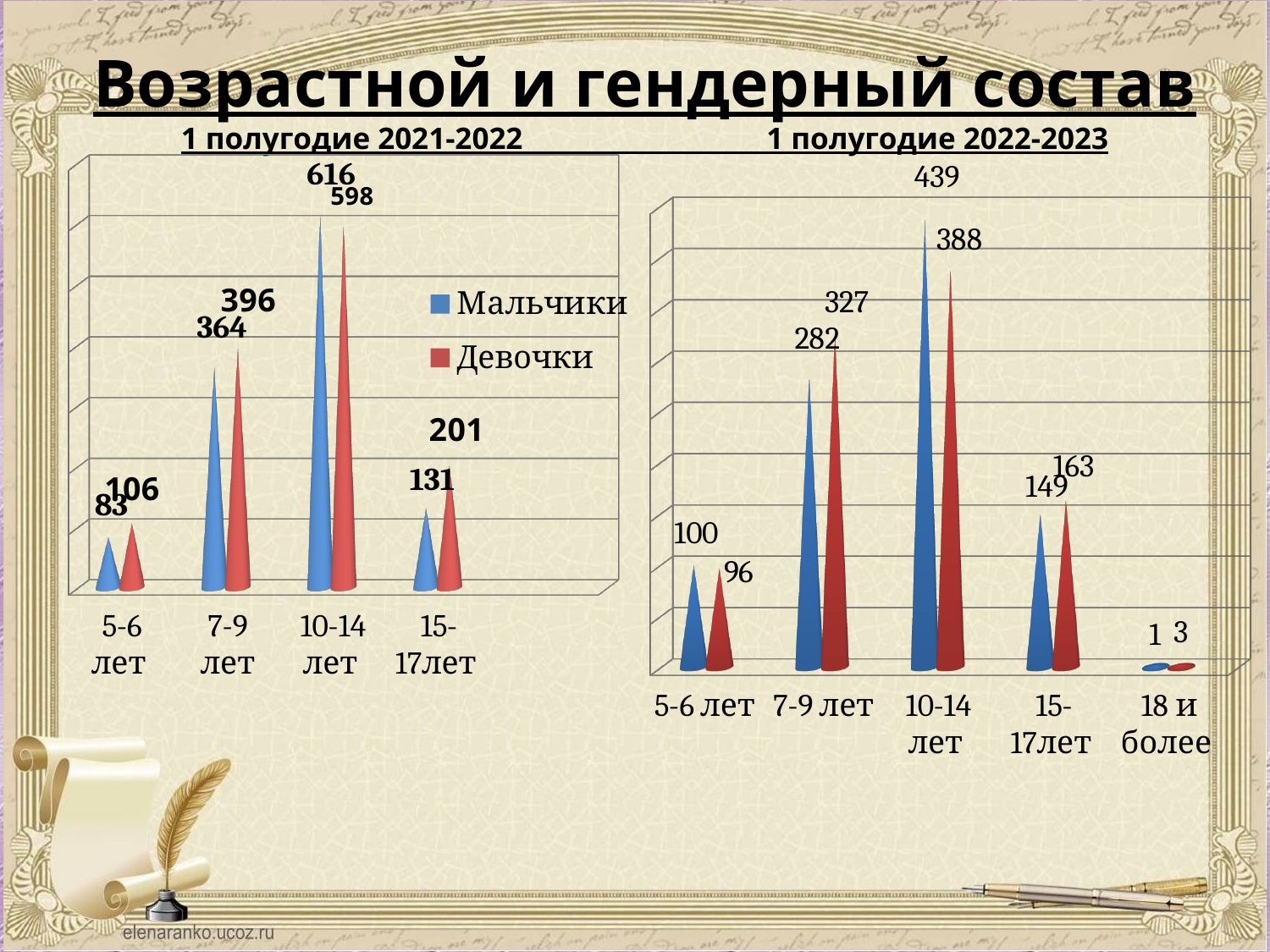
In the chart titled '1 полугодие 2022-2023', what is the value for Мальчики in the 18 и более category? 1 In the chart titled '1 полугодие 2021-2022', what is the difference between the Девочки and Мальчики values in the 7-9 лет category? 32 In the chart titled '1 полугодие 2021-2022', what is the value for Мальчики in the 10-14 лет category? 616 In the chart titled '1 полугодие 2022-2023', which is larger in the 5-6 лет category: Мальчики or Девочки? Мальчики How many age categories does the chart titled '1 полугодие 2022-2023' show? 5 What kind of chart is the chart titled '1 полугодие 2021-2022'? Bar chart How many series does the legend on the slide list? 2 In the chart titled '1 полугодие 2022-2023', which age category has the lowest value for Мальчики? 18 и более In the chart titled '1 полугодие 2021-2022', what is the value for Девочки in the 15-17лет category? 201 In the chart titled '1 полугодие 2022-2023', what is the value for Девочки in the 7-9 лет category? 327 In the chart titled '1 полугодие 2021-2022', which age category has the highest value for Девочки? 10-14 лет In the chart titled '1 полугодие 2022-2023', what is the difference between the Мальчики and Девочки values in the 10-14 лет category? 51